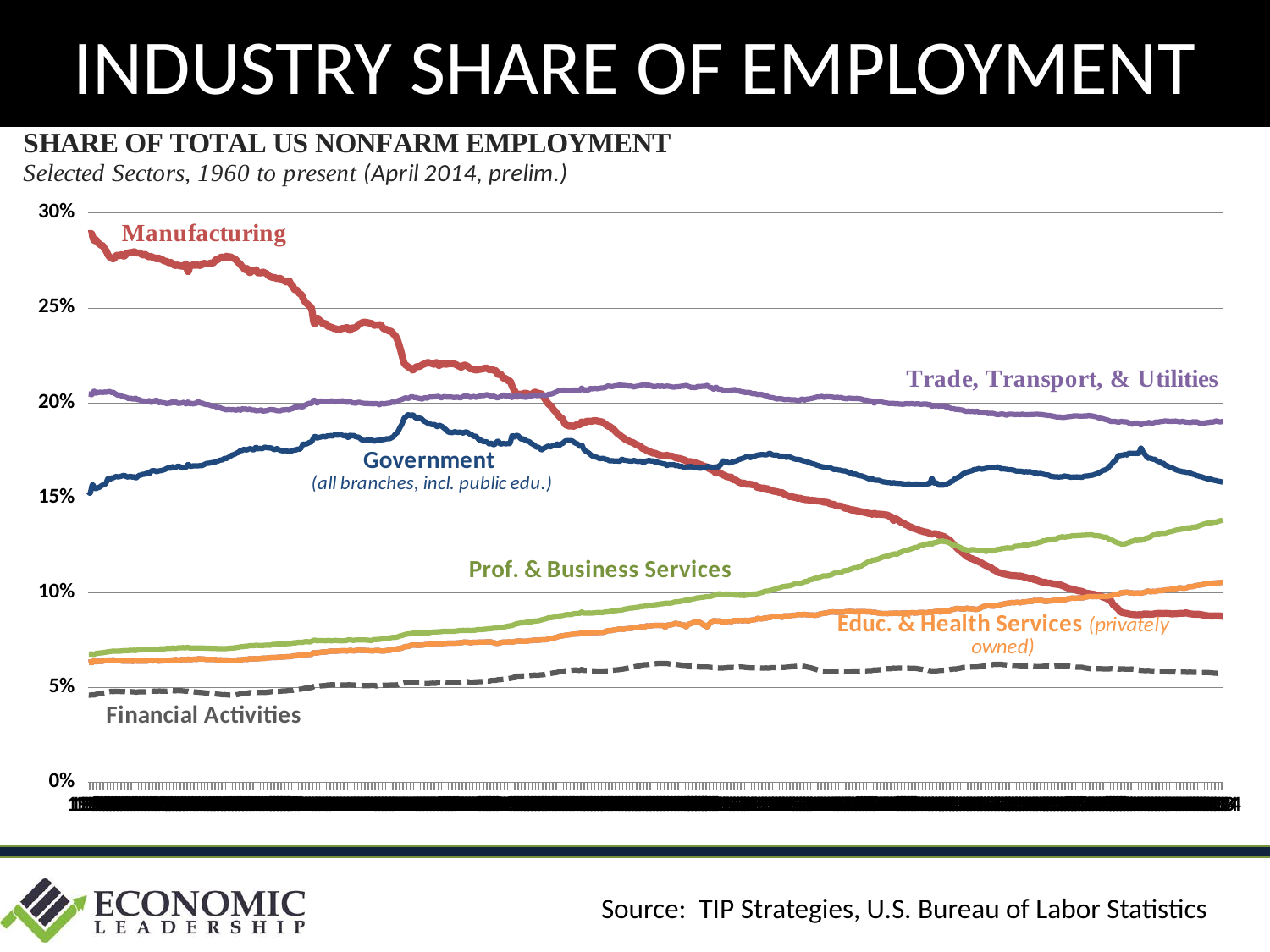
Which sector has the lowest share of employment throughout the chart? Financial Activities Is the Manufacturing share at the start of the chart (1960) greater or less than 25%? greater Does the Prof. & Business Services line rise or fall over the period shown? rise Does the Manufacturing line rise or fall from 1960 to the present? fall Does the Educ. & Health Services line rise or fall over the period shown? rise Is the Manufacturing share at the right end of the chart greater or less than 10%? less What is the title printed above the chart? SHARE OF TOTAL US NONFARM EMPLOYMENT What kind of chart is shown on the slide? line chart How many sectors are plotted as lines on the chart? 6 At the right end of the chart, which is larger: the Educ. & Health Services share or the Manufacturing share? Educ. & Health Services Which sector has the highest share of employment at the right end of the chart? Trade, Transport, & Utilities What is the highest value shown on the vertical axis? 30%